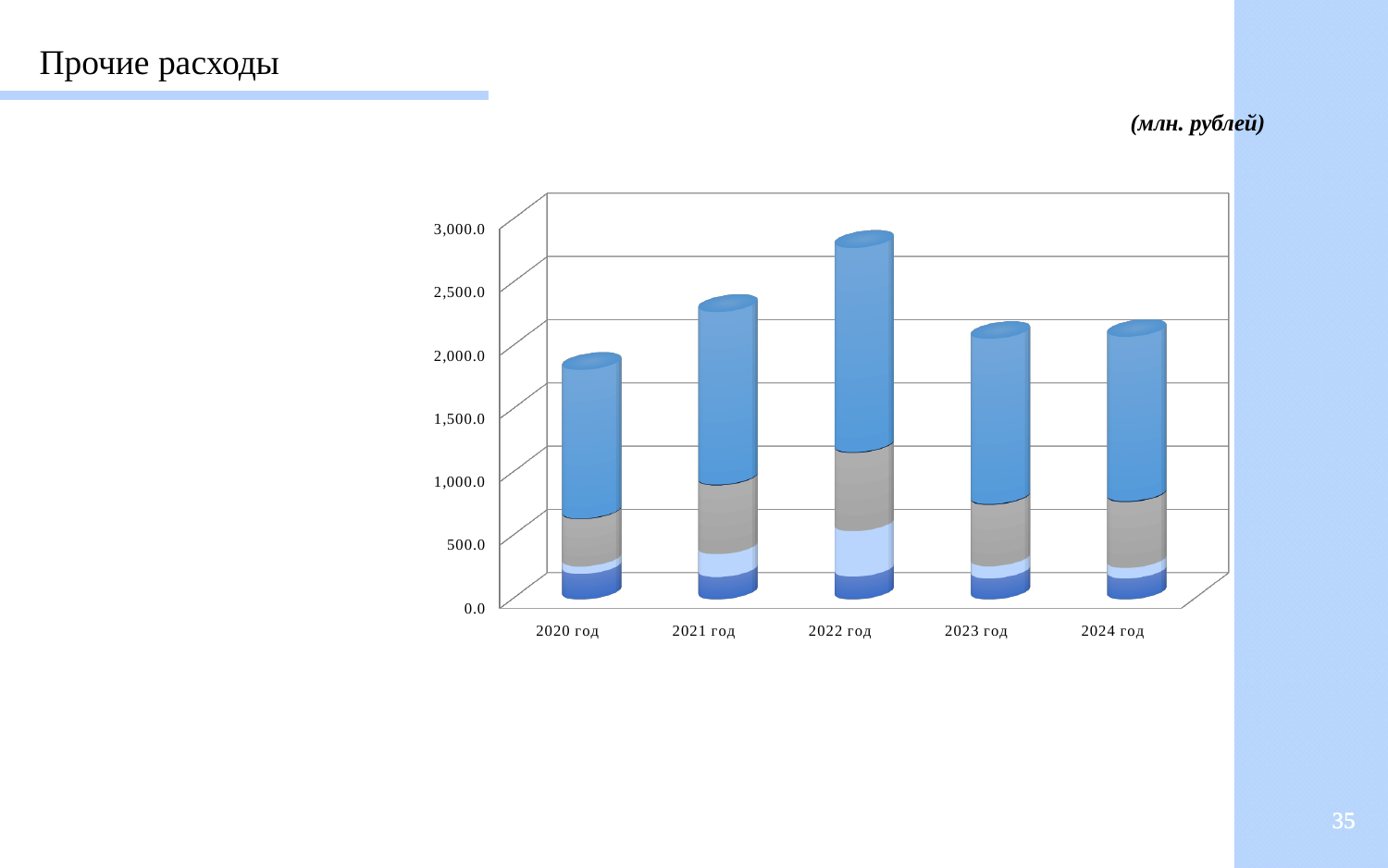
What is the title of the slide containing the chart? Прочие расходы Which year has the lowest total bar in the chart? 2020 год In what units are the chart values expressed, according to the label above the chart? млн. рублей Is the total value for 2021 год greater or less than 2,000.0? greater Is the total value for 2022 год greater or less than 2,500.0? greater Is the total value for 2020 год greater or less than 2,500.0? less Which bar is taller, 2021 год or 2020 год? 2021 год What kind of chart is shown on the slide? Stacked bar chart How many years (categories) are shown on the x axis of the chart? 5 Which bar is taller, 2022 год or 2021 год? 2022 год Which year has the highest total bar in the chart? 2022 год